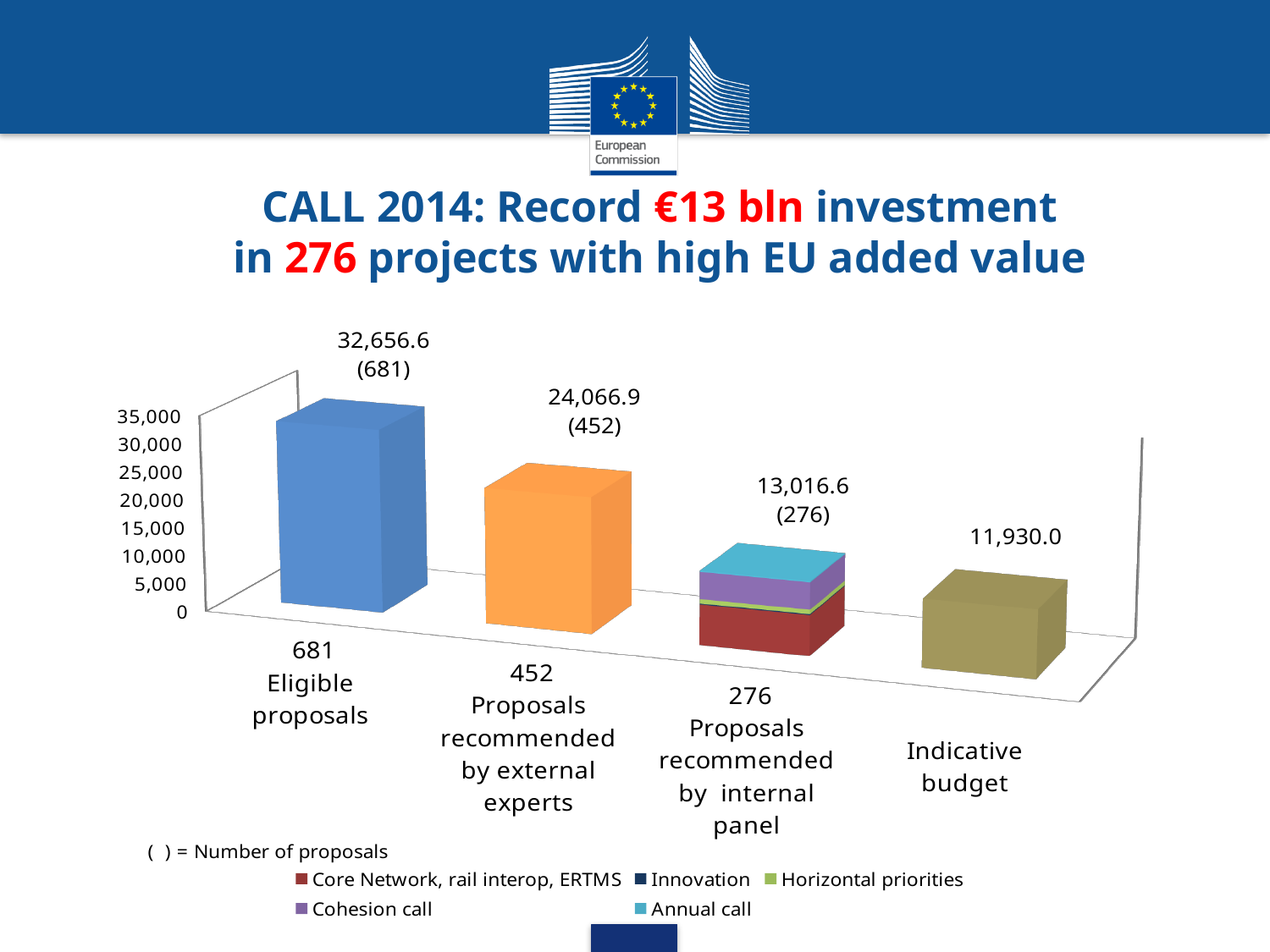
Which category has the lowest value? Indicative budget What is the difference between the values for Eligible proposals and Proposals recommended by external experts? 8,589.7 Which category has the highest value? Eligible proposals How many categories are shown on the x axis? 4 How many proposals are shown in parentheses for Proposals recommended by external experts? 452 What is the total value shown for Proposals recommended by internal panel? 13,016.6 Which is larger: the value for Proposals recommended by internal panel or Indicative budget? Proposals recommended by internal panel What is the value shown for Eligible proposals? 32,656.6 What is the value shown for Indicative budget? 11,930.0 How many series does the legend list? 5 What is the value shown for Proposals recommended by external experts? 24,066.9 What kind of chart is shown on the slide? Bar chart